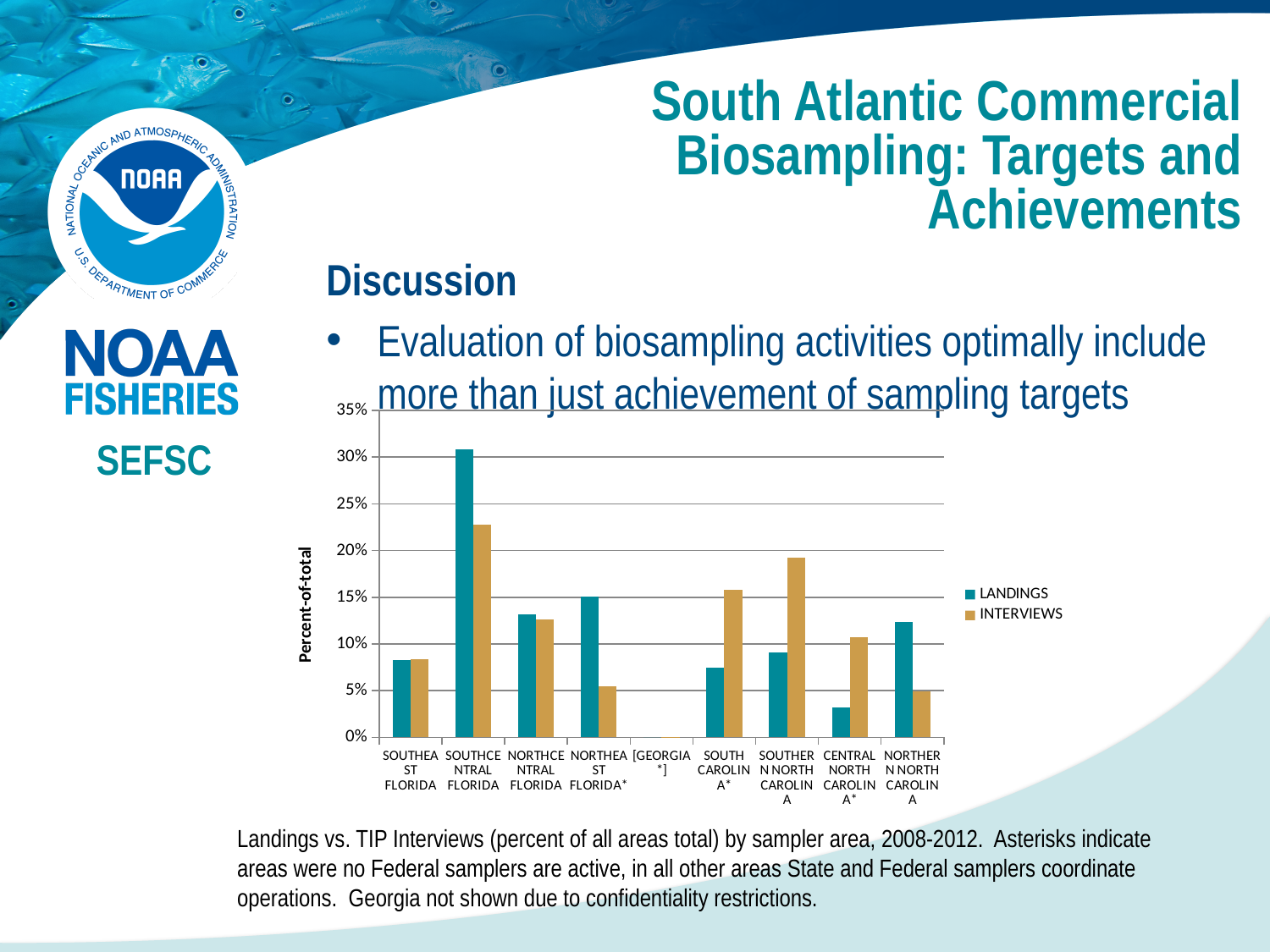
Which sampler area has the highest LANDINGS value? Southcentral Florida Is the INTERVIEWS value for Southcentral Florida greater or less than 20%? greater Is the LANDINGS value for Southcentral Florida greater or less than 25%? greater Is the INTERVIEWS value for Northeast Florida* greater or less than 10%? less For Northeast Florida*, which is larger: LANDINGS or INTERVIEWS? LANDINGS What is the label on the vertical axis of the chart? Percent-of-total What kind of chart is shown on the slide? bar chart Which sampler area has the highest INTERVIEWS value? Southcentral Florida For Southern North Carolina, which is larger: LANDINGS or INTERVIEWS? INTERVIEWS How many series does the chart legend list? 2